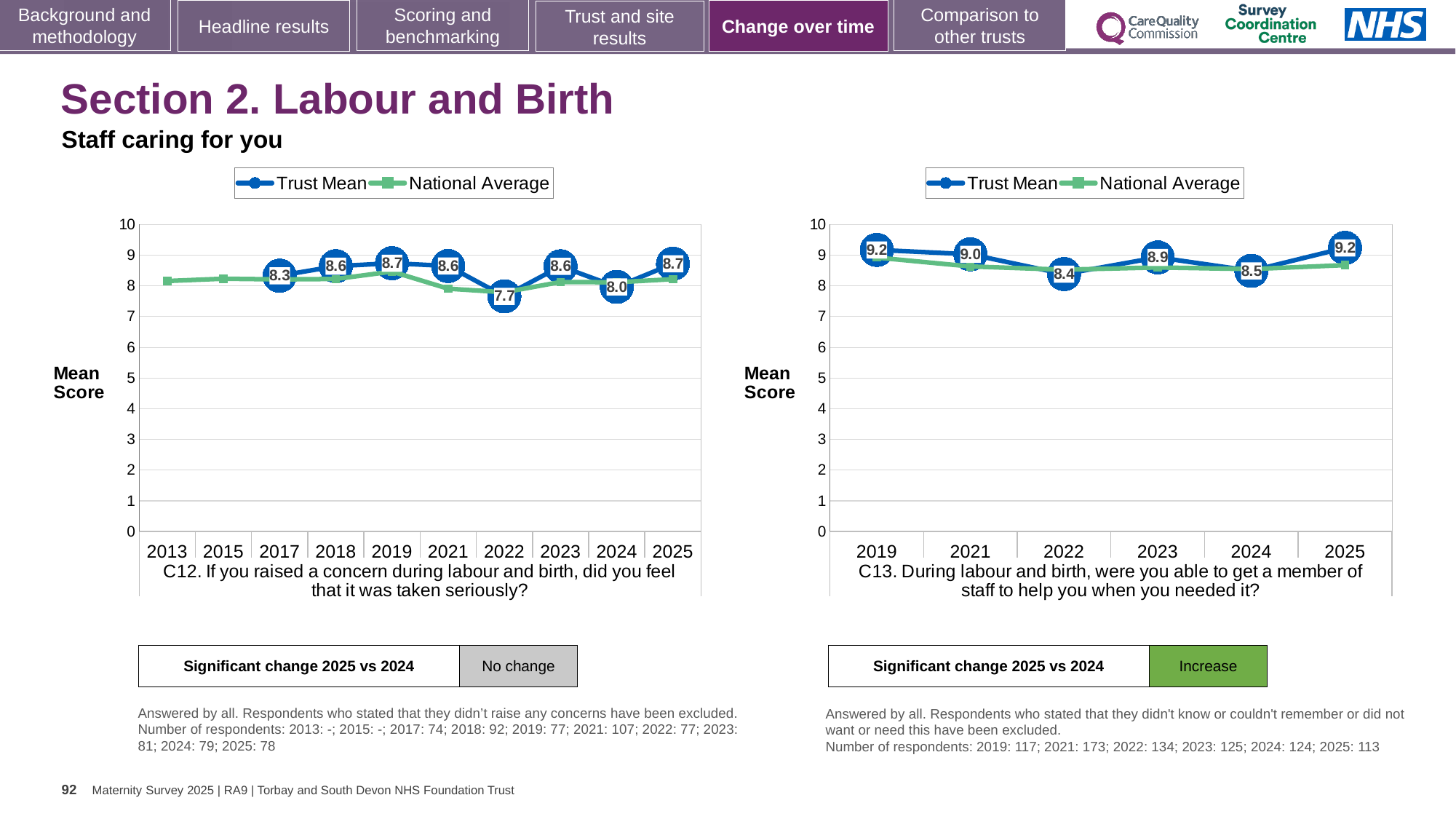
On the left chart (C12), what is the difference between the Trust Mean for 2025 and 2024? 0.7 How many series does the legend of the right chart (C13) list? 2 On the right chart (C13), what is the difference between the Trust Mean for 2019 and 2022? 0.8 On the right chart (C13), which year has the lowest Trust Mean? 2022 What does the 'Significant change 2025 vs 2024' box below the right chart (C13) say? Increase How many years are shown on the x axis of the left chart (C12)? 10 On the right chart (C13), which is larger: the Trust Mean for 2021 or for 2024? 2021 What kind of chart is the right chart (C13)? Line chart On the left chart (C12), is the National Average for 2013 greater or less than 9? less On the left chart (C12), which year has the lowest Trust Mean? 2022 On the right chart (C13), what is the Trust Mean for 2023? 8.9 On the left chart (C12), what is the Trust Mean for 2022? 7.7